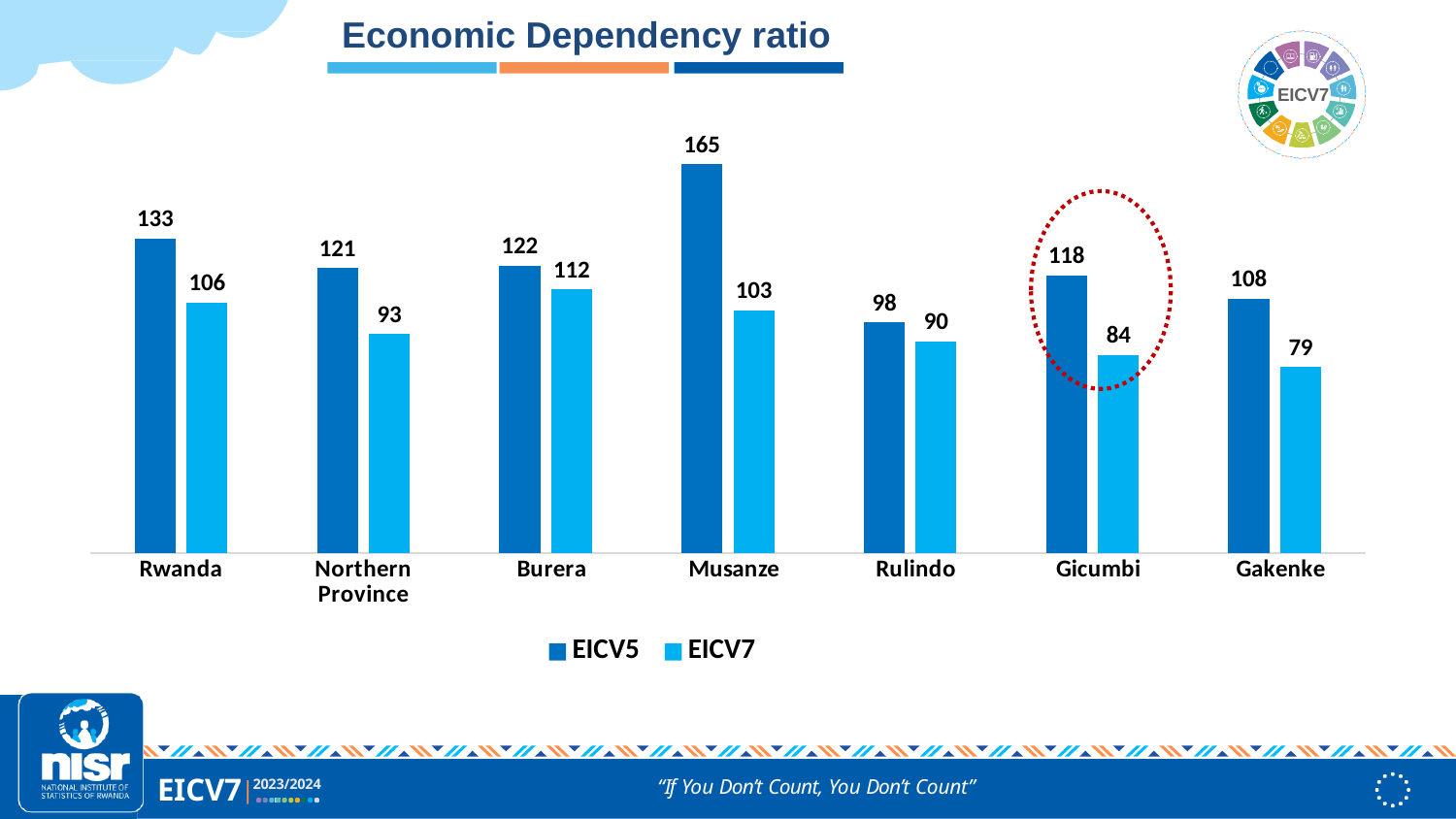
What is the difference between the EICV5 and EICV7 values for Musanze? 62 Which is larger, the EICV7 value for Burera or the EICV7 value for Rulindo? Burera Which category has the highest EICV5 value? Musanze What is the EICV7 economic dependency ratio for Rwanda? 106 Which category is highlighted with a red dotted circle? Gicumbi How many categories are shown on the x axis? 7 What kind of chart is shown on the slide? Bar chart How many series does the legend list? 2 What is the difference between the EICV5 and EICV7 values for Northern Province? 28 What is the EICV5 economic dependency ratio for Musanze? 165 Which category has the lowest EICV7 value? Gakenke What is the EICV7 value for Gicumbi? 84